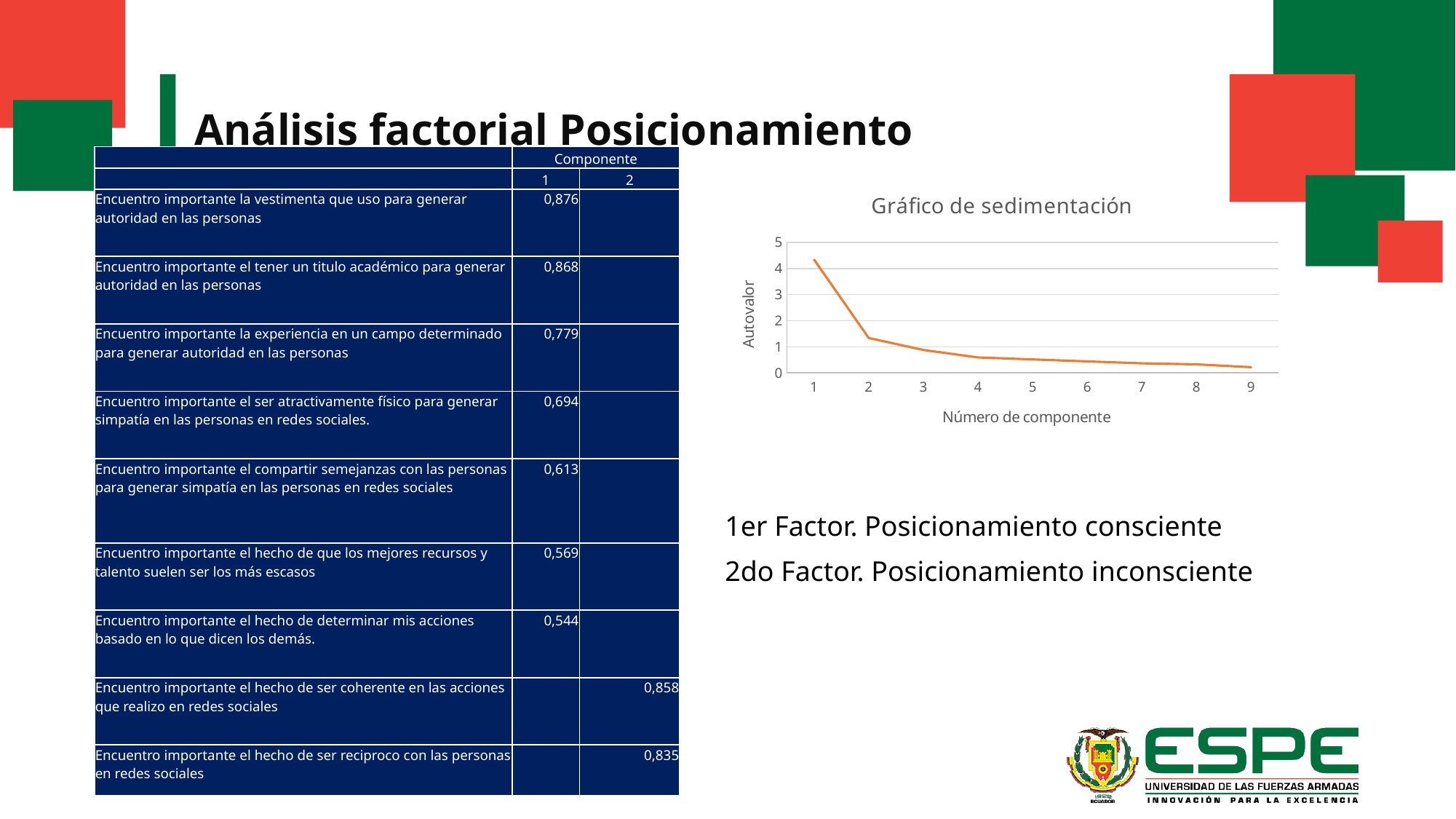
How many components are plotted along the x axis of the 'Gráfico de sedimentación' chart? 9 In the 'Gráfico de sedimentación' chart, is the Autovalor for component 1 greater or less than 4? greater What is the title of the chart on the slide? Gráfico de sedimentación In the 'Gráfico de sedimentación' chart, which component has the highest Autovalor? 1 In the 'Gráfico de sedimentación' chart, is the Autovalor for component 2 greater or less than 1? greater In the 'Gráfico de sedimentación' chart, is the Autovalor for component 3 greater or less than 1? less In the 'Gráfico de sedimentación' chart, which has the larger Autovalor, component 1 or component 2? component 1 What kind of chart is the 'Gráfico de sedimentación'? line chart In the 'Gráfico de sedimentación' chart, do the Autovalor values rise or fall as the component number increases? fall What is the label of the vertical axis of the 'Gráfico de sedimentación' chart? Autovalor